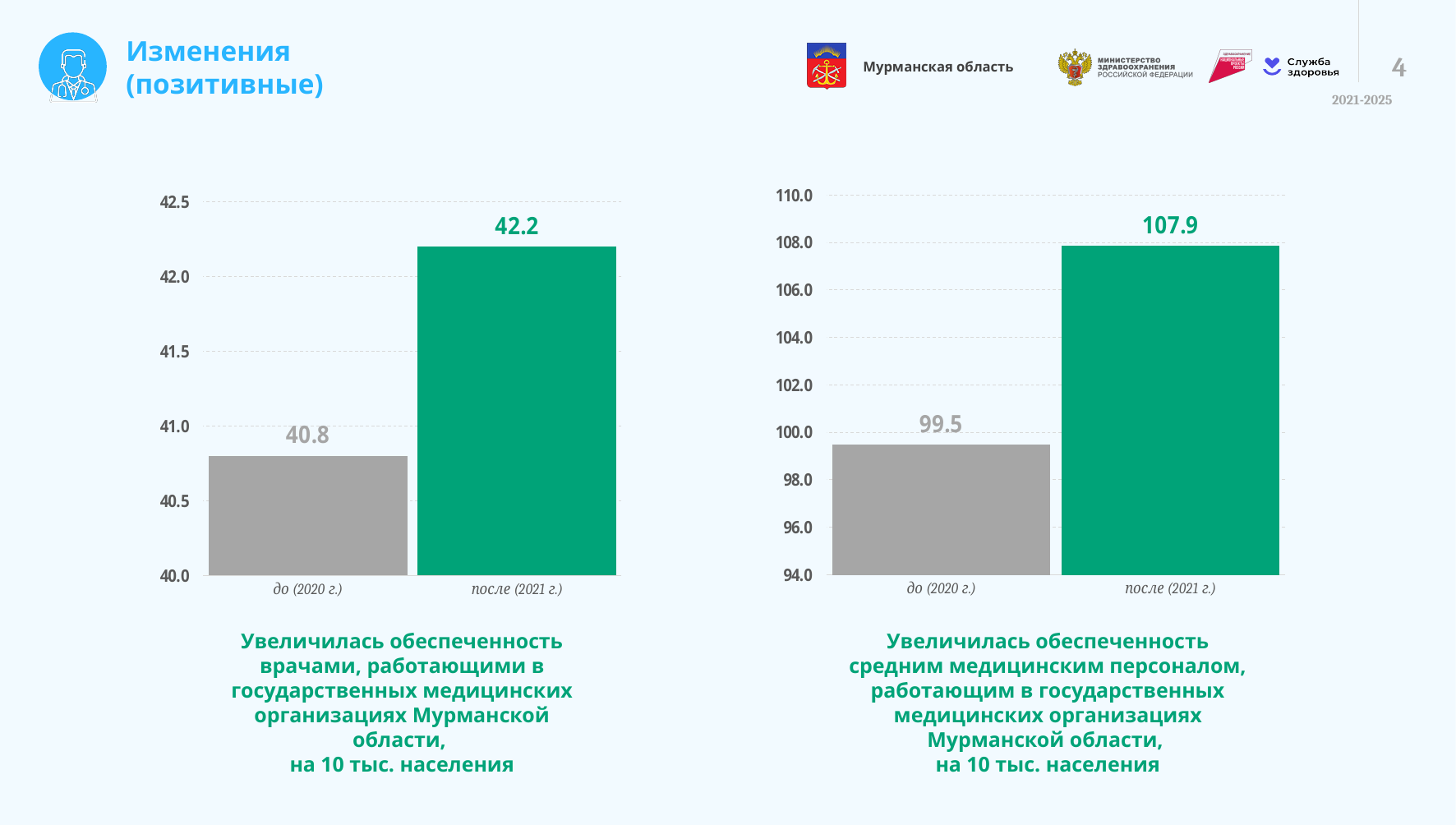
In the left chart, do the values rise or fall from 'до (2020 г.)' to 'после (2021 г.)'? Rise In the right chart, which category has the lower value? до (2020 г.) In the left chart (doctors per 10 thousand population), what is the value for 'до (2020 г.)'? 40.8 In the right chart (mid-level medical staff per 10 thousand population), what is the value for 'до (2020 г.)'? 99.5 How many bars are shown in the left chart? 2 In the right chart, is the value for 'до (2020 г.)' greater or less than 100.0? less In the left chart, which category has the higher value? после (2021 г.) What type of chart is the right chart? Bar chart In the right chart (mid-level medical staff per 10 thousand population), what is the value for 'после (2021 г.)'? 107.9 In the right chart, what is the difference between the 'после (2021 г.)' and 'до (2020 г.)' values? 8.4 In the left chart (doctors per 10 thousand population), what is the value for 'после (2021 г.)'? 42.2 In the left chart, what is the difference between the 'после (2021 г.)' and 'до (2020 г.)' values? 1.4